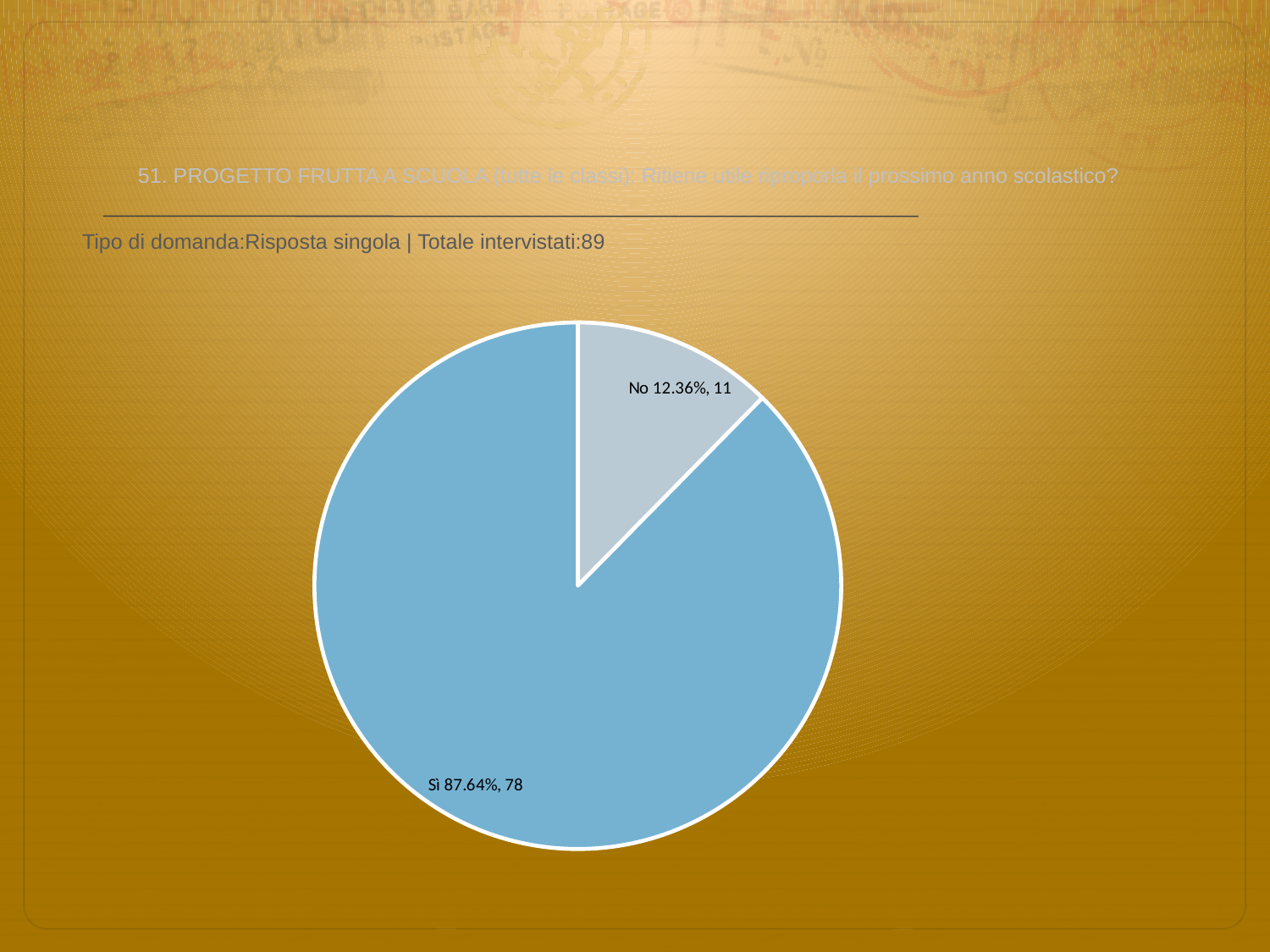
How many respondents answered 'Sì'? 78 How many respondents answered 'No'? 11 What is the difference in the number of respondents between 'Sì' and 'No'? 67 What percentage share does the 'Sì' slice have? 87.64% What is the total number of respondents across both slices? 89 Which has more respondents, 'Sì' or 'No'? Sì Which slice is the smallest in the pie chart? No What colour is the 'Sì' slice? blue What kind of chart is shown on the slide? pie chart What percentage share does the 'No' slice have? 12.36% Which slice is the largest in the pie chart? Sì How many slices does the pie chart have? 2